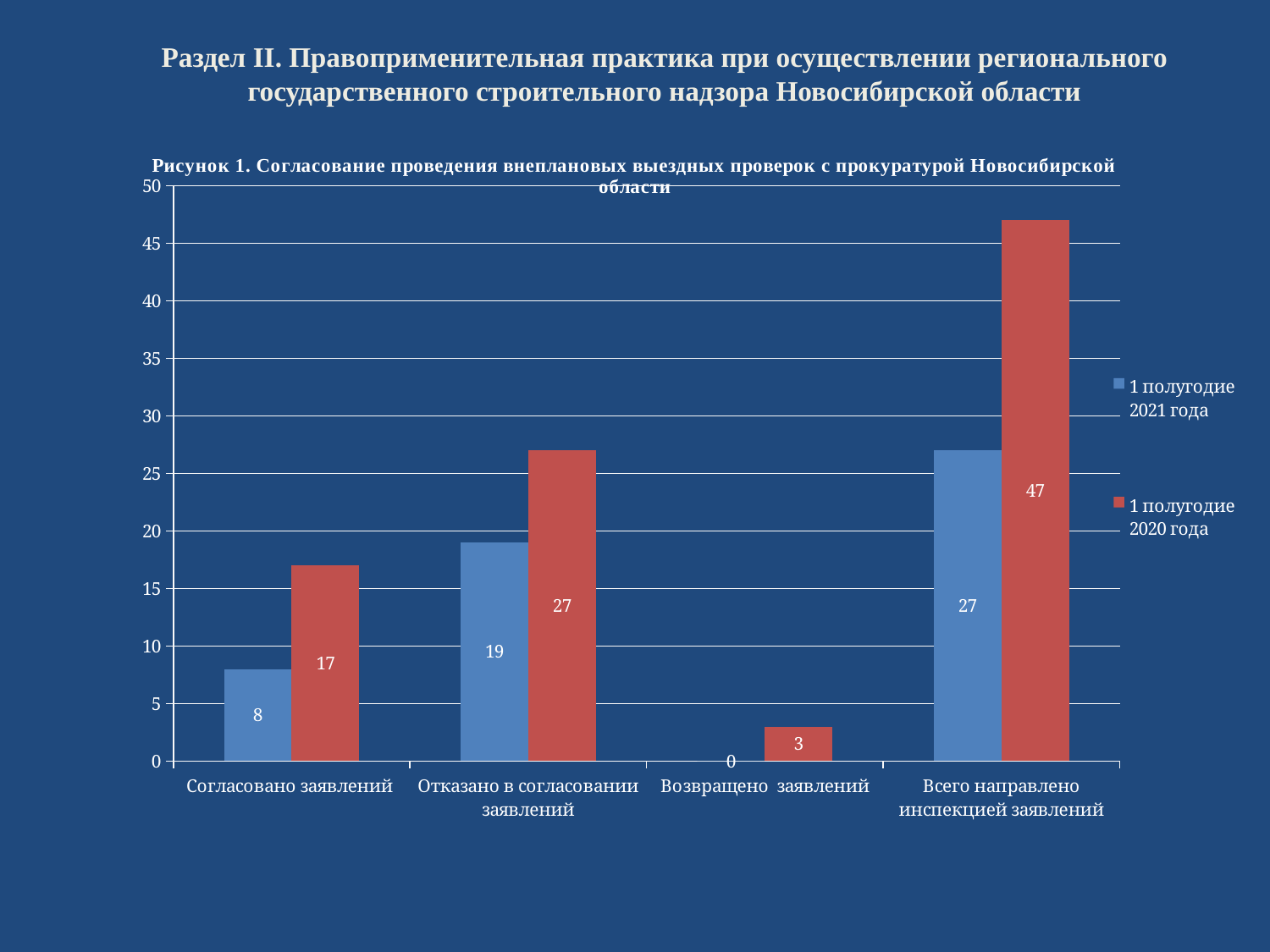
How many series does the legend list? 2 How many categories are shown on the x axis? 4 What is the value for "Отказано в согласовании заявлений" in the series "1 полугодие 2020 года"? 27 Which category has the lowest value in the series "1 полугодие 2021 года"? Возвращено заявлений What is the value for "Всего направлено инспекцией заявлений" in the series "1 полугодие 2020 года"? 47 For "Согласовано заявлений", which series has the larger value: "1 полугодие 2021 года" or "1 полугодие 2020 года"? 1 полугодие 2020 года What is the value for "Возвращено заявлений" in the series "1 полугодие 2021 года"? 0 What is the difference between the "1 полугодие 2020 года" and "1 полугодие 2021 года" values for "Всего направлено инспекцией заявлений"? 20 Which category has the highest value in the series "1 полугодие 2020 года"? Всего направлено инспекцией заявлений Which series is shown in red? 1 полугодие 2020 года What type of chart is shown on the slide? Bar chart What is the value for "Согласовано заявлений" in the series "1 полугодие 2021 года"? 8